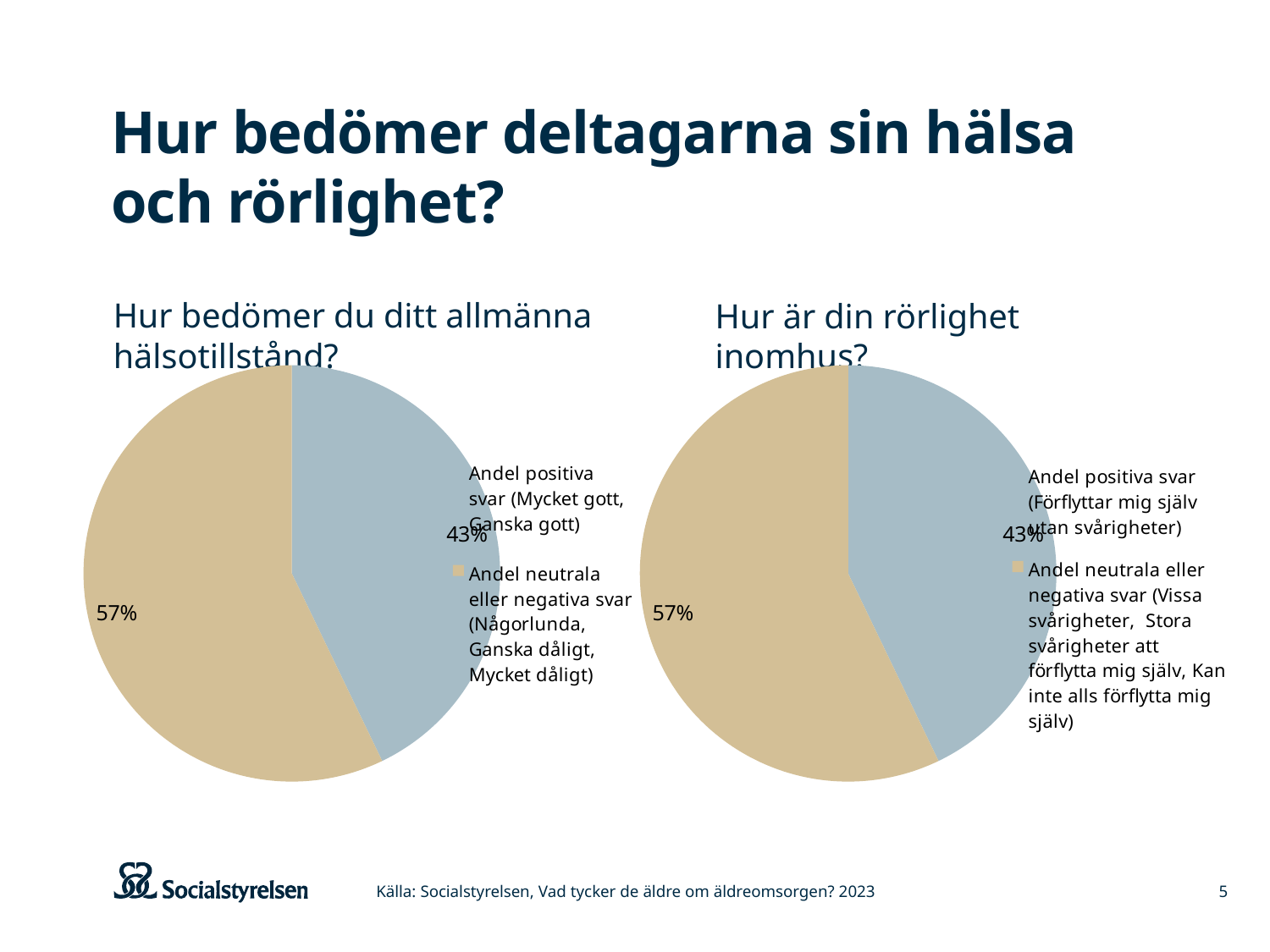
In the chart 'Hur bedömer du ditt allmänna hälsotillstånd?', which slice is the largest? Andel neutrala eller negativa svar In the chart 'Hur bedömer du ditt allmänna hälsotillstånd?', what share is 'Andel neutrala eller negativa svar'? 57% In the chart 'Hur bedömer du ditt allmänna hälsotillstånd?', what is the difference in percentage points between the neutral/negative share and the positive share? 14 percentage points In the chart 'Hur är din rörlighet inomhus?', is the positive share larger or smaller than the neutral/negative share? Smaller What kind of chart is used for 'Hur bedömer du ditt allmänna hälsotillstånd?'? Pie chart How many pie charts are shown on the slide? 2 In the chart 'Hur är din rörlighet inomhus?', what share is 'Andel positiva svar (Förflyttar mig själv utan svårigheter)'? 43% In the chart 'Hur bedömer du ditt allmänna hälsotillstånd?', what share is 'Andel positiva svar (Mycket gott, Ganska gott)'? 43% In the chart 'Hur är din rörlighet inomhus?', which slice is the smallest? Andel positiva svar How many slices does the chart 'Hur är din rörlighet inomhus?' have? 2 In the chart 'Hur bedömer du ditt allmänna hälsotillstånd?', what colour is the 'Andel positiva svar' slice? Blue-grey